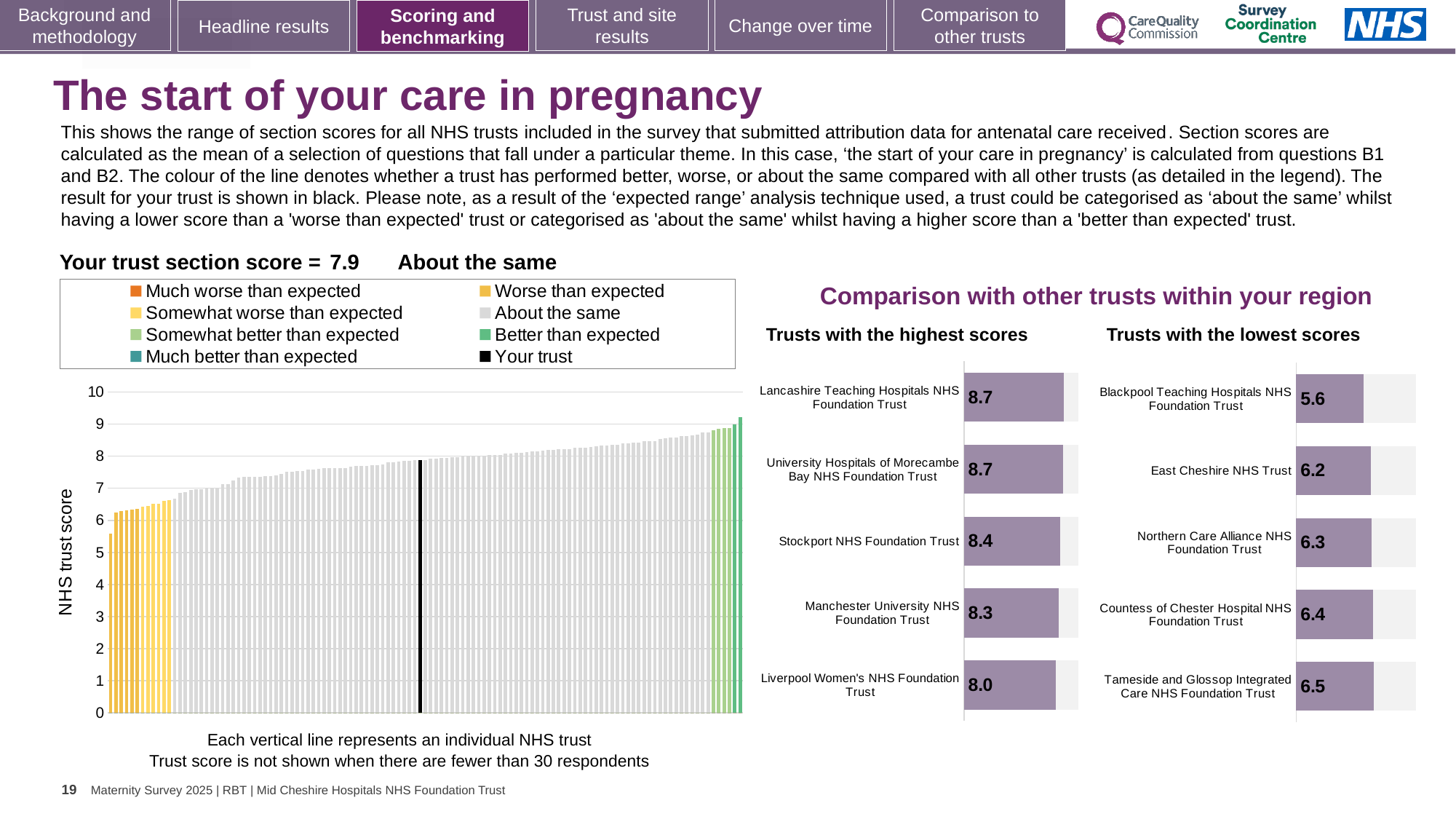
In the 'Trusts with the lowest scores' chart, which has the larger score: East Cheshire NHS Trust or Countess of Chester Hospital NHS Foundation Trust? Countess of Chester Hospital NHS Foundation Trust How many entries does the legend of the NHS trust score chart on the left list? 8 In the 'Trusts with the highest scores' chart, what is the difference between the scores of Stockport NHS Foundation Trust and Liverpool Women's NHS Foundation Trust? 0.4 In the NHS trust score chart on the left, do the bar values rise or fall from left to right? Rise In the 'Trusts with the lowest scores' chart, what is the difference between the scores of Tameside and Glossop Integrated Care NHS Foundation Trust and Blackpool Teaching Hospitals NHS Foundation Trust? 0.9 In the NHS trust score chart on the left, what is the section score for your trust (the black bar)? 7.9 In the 'Trusts with the lowest scores' chart, which trust has the lowest score? Blackpool Teaching Hospitals NHS Foundation Trust What kind of chart is the NHS trust score chart on the left? Bar chart In the 'Trusts with the lowest scores' chart, what is the score for Blackpool Teaching Hospitals NHS Foundation Trust? 5.6 In the 'Trusts with the lowest scores' chart, which trust has the highest score? Tameside and Glossop Integrated Care NHS Foundation Trust In the 'Trusts with the highest scores' chart, what is the score for Stockport NHS Foundation Trust? 8.4 How many trusts are listed in the 'Trusts with the highest scores' chart? 5